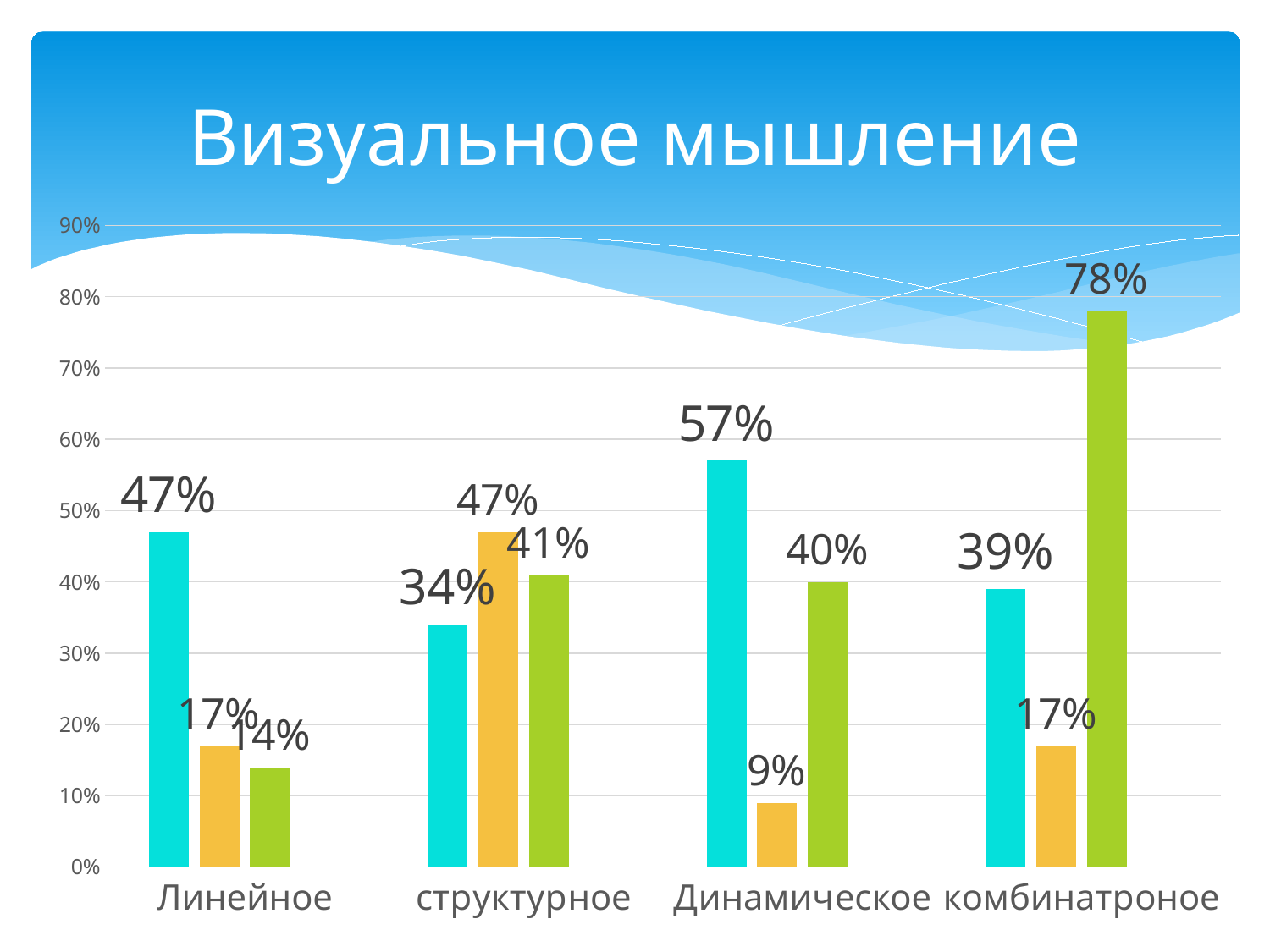
What is the value of the cyan bar for Линейное? 47% Which is larger for структурное, the cyan bar or the green bar? the green bar What is the value of the orange bar for Динамическое? 9% Do the values of the green bars rise or fall from Динамическое to комбинатроное? rise Which category has the highest cyan bar? Динамическое What is the title of the chart? Визуальное мышление What type of chart is shown on the slide? bar chart How many categories are shown on the x axis? 4 What is the difference between the green bar and the cyan bar for комбинатроное? 39% What is the value of the orange bar for структурное? 47% Which category has the lowest green bar? Линейное What is the value of the green bar for комбинатроное? 78%